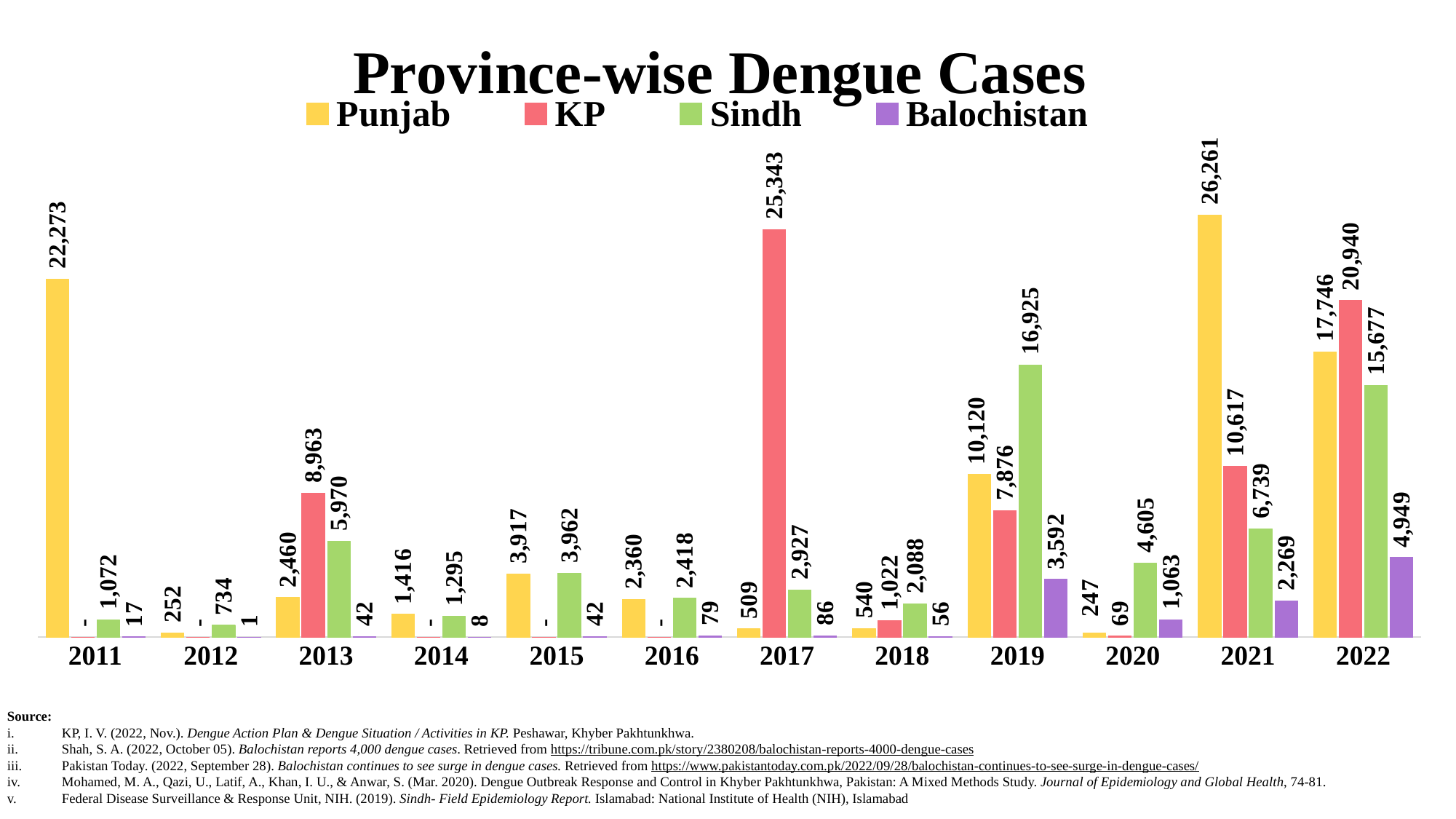
In which year did Punjab record its highest number of dengue cases? 2021 Which province had more dengue cases in 2019, Punjab or KP? Punjab How many series does the legend list? 4 What is the number of dengue cases in KP in 2017? 25,343 Which province had the lowest number of dengue cases in 2020? KP What is the difference between KP's and Punjab's dengue cases in 2022? 3,194 What kind of chart is shown on the slide? Bar chart How many years are shown on the x axis? 12 What is the number of dengue cases in Balochistan in 2022? 4,949 What is the number of dengue cases in Sindh in 2019? 16,925 What is the number of dengue cases in Punjab in 2011? 22,273 What is the title of the chart? Province-wise Dengue Cases